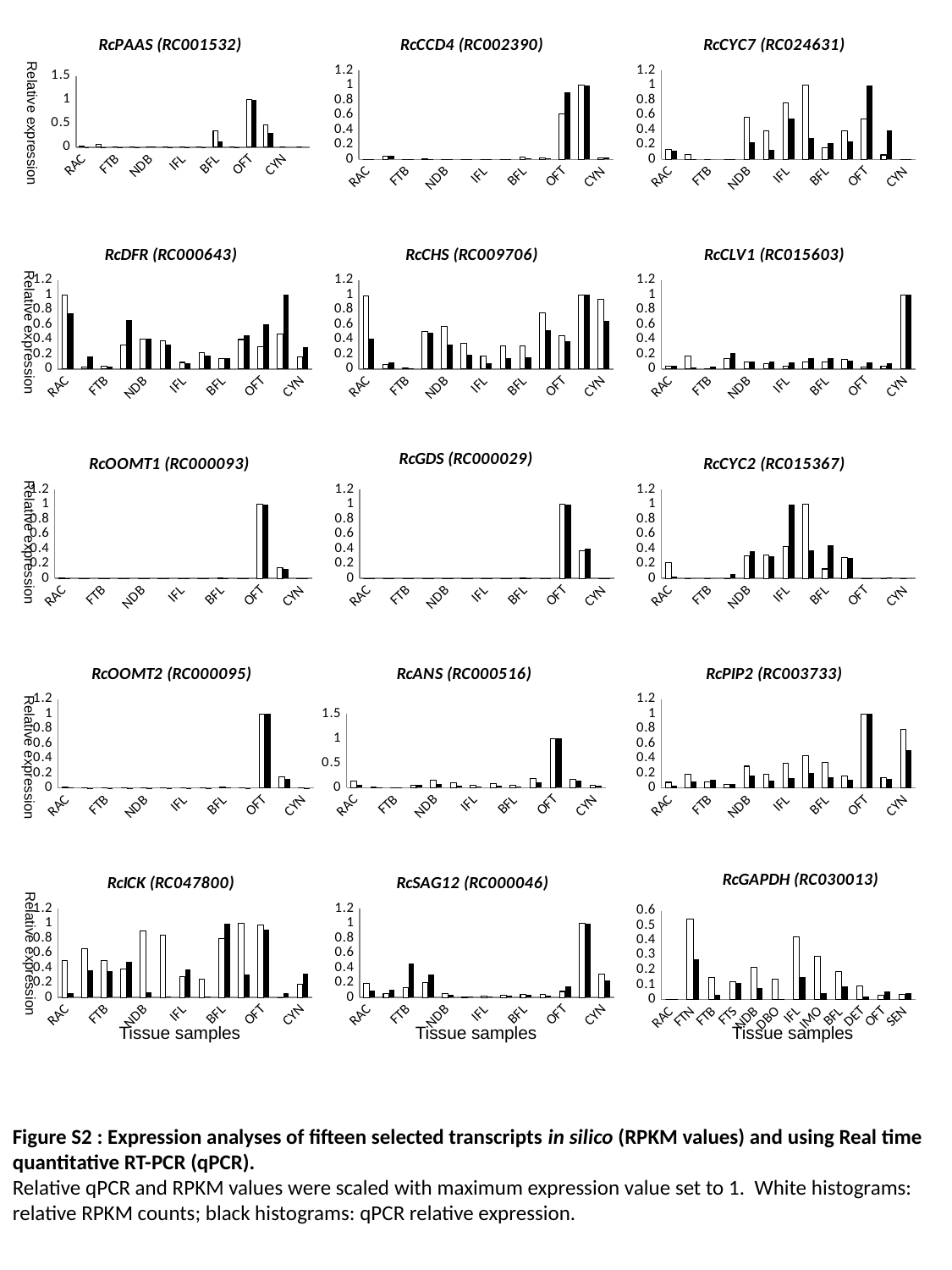
In the RcOOMT2 (RC000095) chart, what is the value of the black bar for OFT? 1 In the RcGAPDH (RC030013) chart, is the white bar for FTN greater or less than 0.4? greater In the RcGDS (RC000029) chart, which tissue sample has the highest expression? OFT In the RcPIP2 (RC003733) chart, which black bar is taller, OFT or CYN? OFT In the RcOOMT1 (RC000093) chart, which tissue sample has the highest expression? OFT What is the y-axis label on the RcDFR (RC000643) chart? Relative expression How many tissue samples are shown on the x axis of the RcGAPDH (RC030013) chart? 12 In the RcCCD4 (RC002390) chart, is the white bar for OFT greater or less than 0.4? greater In the RcCHS (RC009706) chart, which white bar is taller, RAC or FTB? RAC In the RcCLV1 (RC015603) chart, which tissue sample has the highest expression? CYN What kind of chart is used for RcPAAS (RC001532)? bar chart